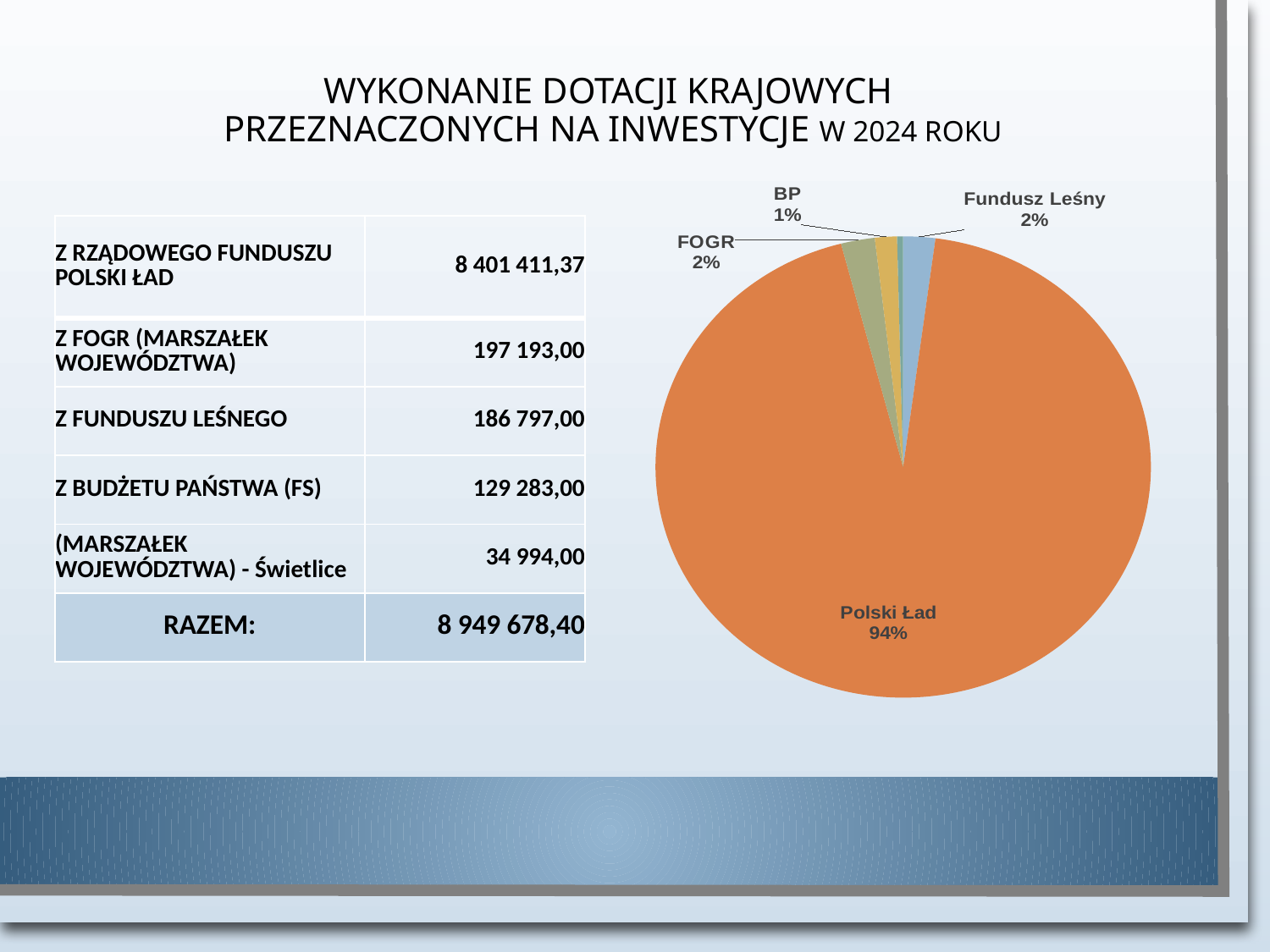
Which slice of the pie chart is the largest? Polski Ład What share of the pie does Polski Ład account for? 94% What share of the pie does BP account for? 1% Which is larger in the pie chart, the Polski Ład slice or the FOGR slice? Polski Ład What kind of chart is shown on the slide? pie chart Is the share for Polski Ład greater or less than 50%? greater By how many percentage points does the Polski Ład share exceed the Fundusz Leśny share? 92 percentage points By how many percentage points does the Polski Ład share exceed the BP share? 93 percentage points What share of the pie does Fundusz Leśny account for? 2% Which is larger in the pie chart, the FOGR slice or the BP slice? FOGR What colour is the Polski Ład slice in the pie chart? orange